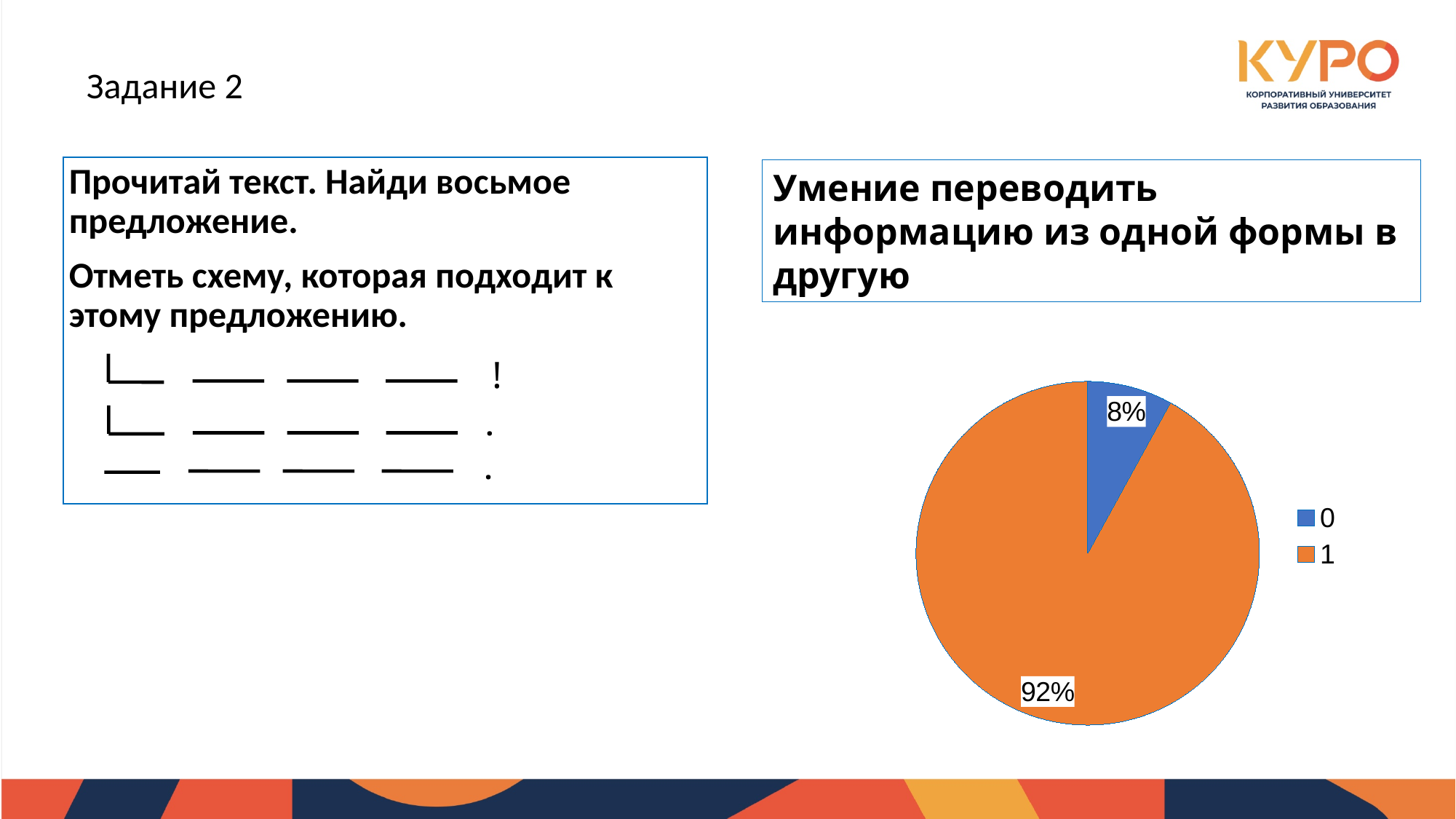
What is the difference in percentage points between the slices for 1 and 0? 84 Which category has the smallest slice of the pie? 0 Which slice is larger, the one for 0 or the one for 1? 1 How many entries does the legend list? 2 What share of the pie does category 1 take? 92% What colour is the slice for category 0? blue What share of the pie does category 0 take? 8% How many slices does the pie chart have? 2 What colour is the slice for category 1? orange Which category has the largest slice of the pie? 1 What kind of chart is shown on the slide? pie chart